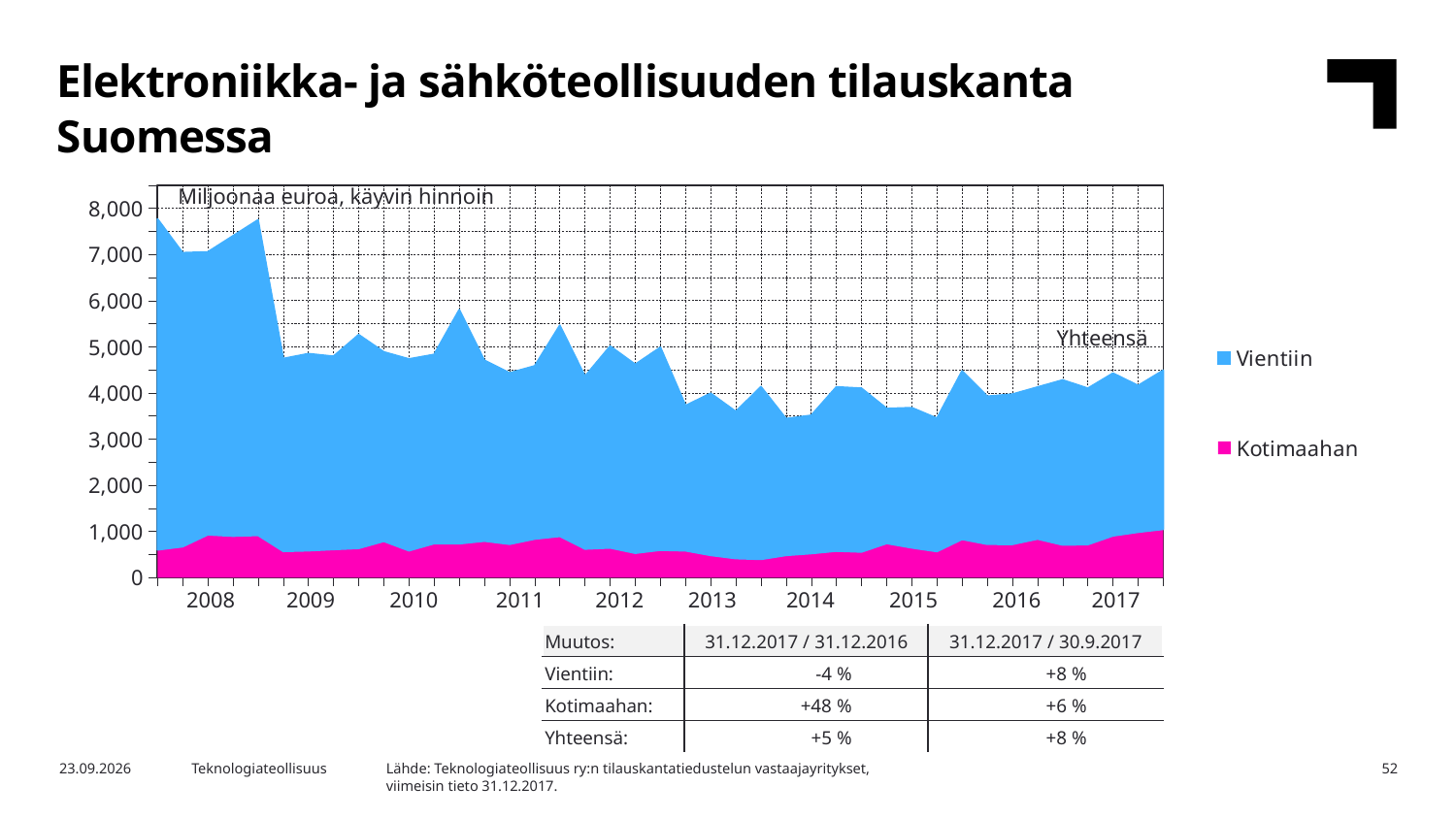
How many series does the legend list? 2 Does the total order book overall rise or fall from 2008 to 2017? fall Is the Kotimaahan value in 2013 greater or less than 1,000? less In which year does the total order book reach its highest level? 2008 What unit is stated at the top of the chart area? Miljoonaa euroa, käyvin hinnoin What are the two series named in the legend? Vientiin and Kotimaahan Is the total order book (Yhteensä) at the end of 2017 greater or less than 5,000? less Is the total order book (Yhteensä) at the start of 2008 greater or less than 7,000? greater Which series, Vientiin or Kotimaahan, has the larger values throughout the chart? Vientiin How many years are labelled on the x axis? 10 What kind of chart is shown on the slide? Stacked area chart